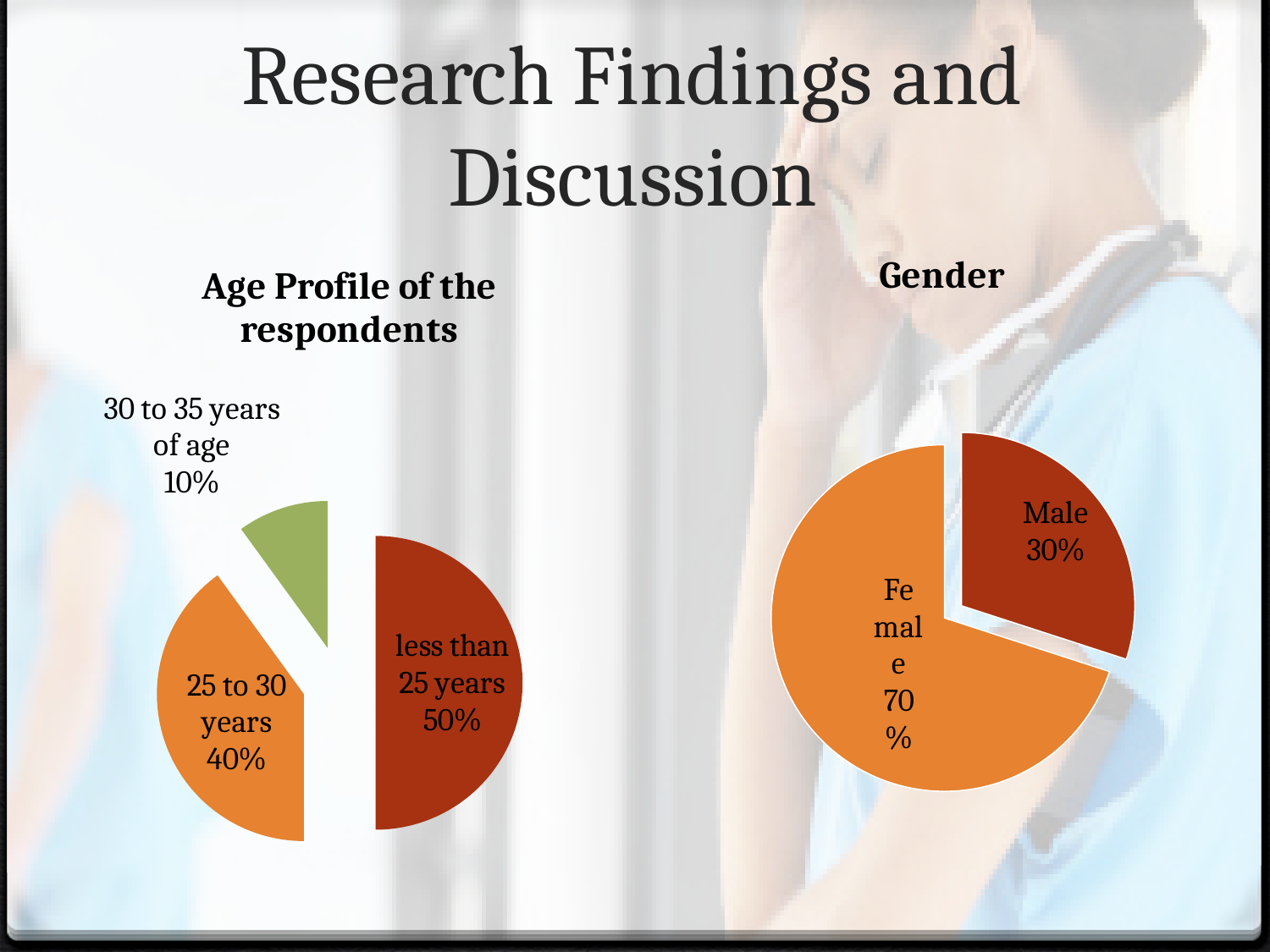
What kind of chart is the 'Gender' chart? pie chart In the 'Gender' chart, which is larger, the Male slice or the Female slice? Female How many slices does the 'Age Profile of the respondents' chart have? 3 In the 'Gender' chart, what share of respondents are male? 30% In the 'Age Profile of the respondents' chart, which age group has the largest share? less than 25 years In the 'Age Profile of the respondents' chart, which age group has the smallest share? 30 to 35 years of age In the 'Gender' chart, what share of respondents are female? 70% In the 'Age Profile of the respondents' chart, what share of respondents are 25 to 30 years old? 40% In the 'Age Profile of the respondents' chart, what share of respondents are less than 25 years old? 50% In the 'Age Profile of the respondents' chart, what is the difference in percentage points between the 'less than 25 years' and '30 to 35 years of age' slices? 40 In the 'Age Profile of the respondents' chart, what share of respondents are 30 to 35 years of age? 10% In the 'Gender' chart, what is the difference in percentage points between the Female and Male slices? 40